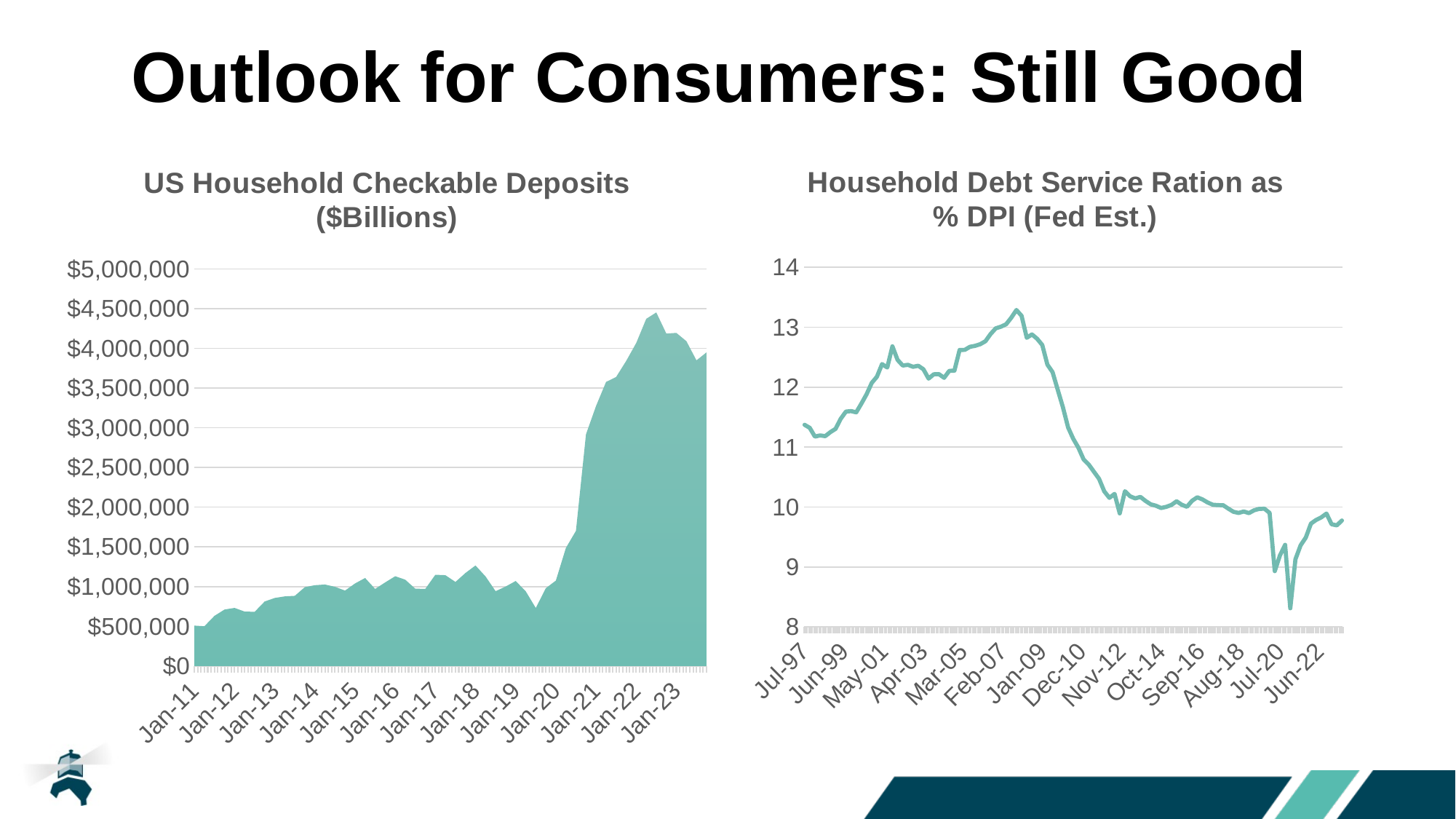
In the 'US Household Checkable Deposits ($Billions)' chart, do the values rise or fall between Jan-20 and Jan-22? rise In the 'Household Debt Service Ration as % DPI (Fed Est.)' chart, is the value at Jun-22 greater or less than 10? less What kind of chart is the 'US Household Checkable Deposits ($Billions)' chart on the left? Area chart In the 'Household Debt Service Ration as % DPI (Fed Est.)' chart, is the value at Jul-97 greater or less than 11? greater What is the title of the chart on the right side of the slide? Household Debt Service Ration as % DPI (Fed Est.) What is the highest value shown on the y-axis of the 'US Household Checkable Deposits ($Billions)' chart? $5,000,000 What kind of chart is the 'Household Debt Service Ration as % DPI (Fed Est.)' chart on the right? Line chart In the 'Household Debt Service Ration as % DPI (Fed Est.)' chart, do the values rise or fall between Jan-09 and Dec-10? fall In the 'US Household Checkable Deposits ($Billions)' chart, is the value at Jan-11 greater or less than $1,000,000? less